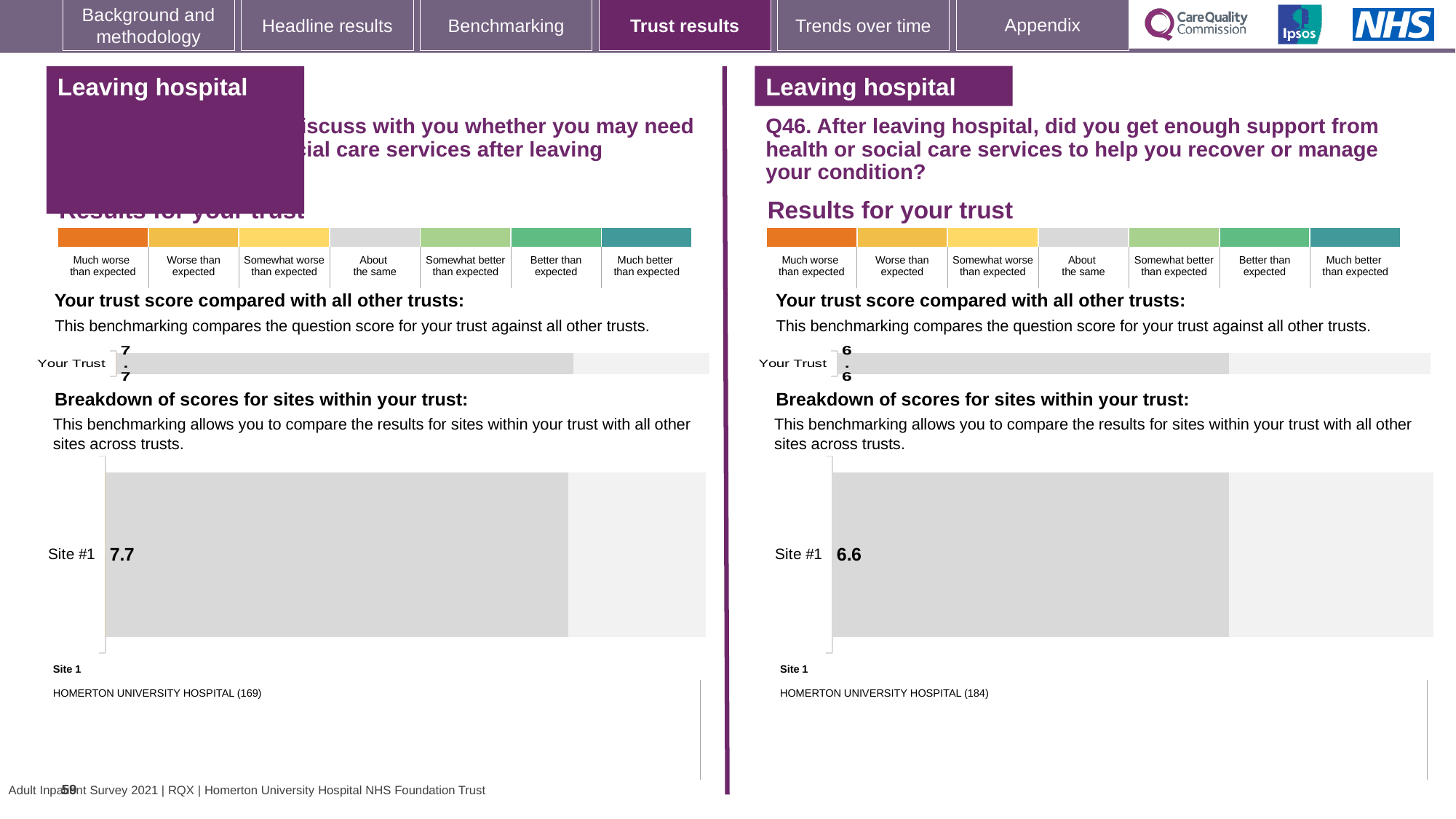
What kind of chart is used to show the Your Trust score on the right half of the slide (Q46)? Bar chart What kind of chart is used in the left 'Breakdown of scores for sites within your trust' section? Bar chart How many sites are plotted in the left 'Breakdown of scores for sites within your trust' chart? 1 In the left 'Breakdown of scores for sites within your trust' chart, what is the score for Site #1? 7.7 In the right 'Breakdown of scores for sites within your trust' chart (Q46), what is the score for Site #1? 6.6 What is the difference between the Your Trust score on the left half of the slide and the Your Trust score on the right half (Q46)? 1.1 On the left half of the slide, what is the value shown for Your Trust in the 'Your trust score compared with all other trusts' chart? 7.7 In the right breakdown chart (Q46), which site is labelled as Site 1? HOMERTON UNIVERSITY HOSPITAL (184) In the left breakdown chart, which site is labelled as Site 1? HOMERTON UNIVERSITY HOSPITAL (169) On the right half of the slide (Q46), what is the value shown for Your Trust in the 'Your trust score compared with all other trusts' chart? 6.6 Which is larger: the Site #1 score in the left breakdown chart or the Site #1 score in the right breakdown chart (Q46)? Left (7.7) How many sites are plotted in the right 'Breakdown of scores for sites within your trust' chart (Q46)? 1